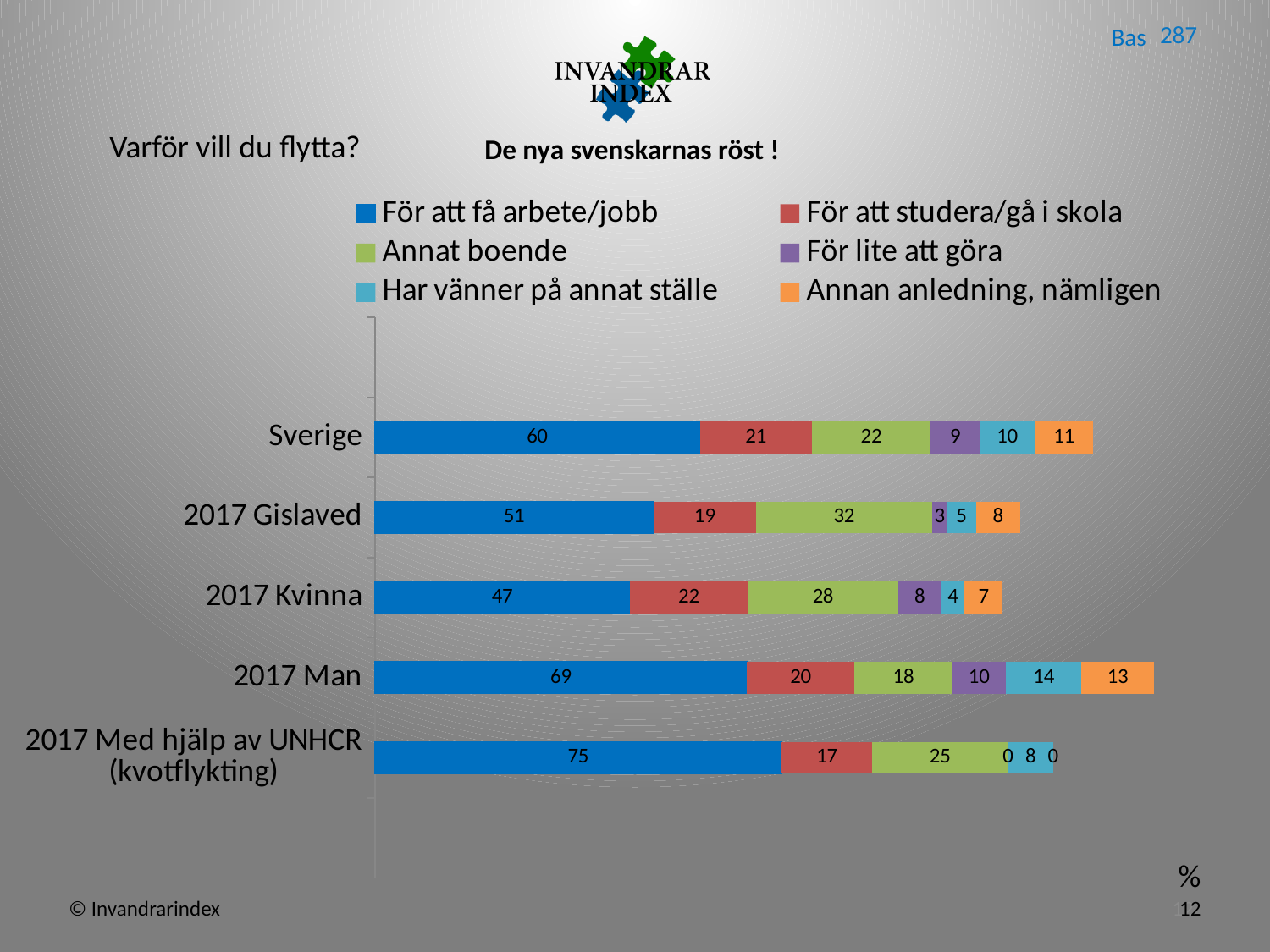
Which category has the highest value for 'För att få arbete/jobb'? 2017 Med hjälp av UNHCR (kvotflykting) What is the value of 'För att få arbete/jobb' for 2017 Man? 69 How many categories are plotted on the chart? 5 What is the value of 'Annat boende' for 2017 Gislaved? 32 What is the value of 'Har vänner på annat ställe' for Sverige? 10 Which is larger: 'Annan anledning, nämligen' for 2017 Man or for Sverige? 2017 Man What is the difference between the 'För att få arbete/jobb' values for 2017 Man and 2017 Kvinna? 22 What kind of chart is shown on the slide? Stacked bar chart How many series does the legend list? 6 Which category has the lowest value for 'För att få arbete/jobb'? 2017 Kvinna What is the 'Bas' number shown in the top right corner of the slide? 287 What is the total of the stacked bar for Sverige? 133